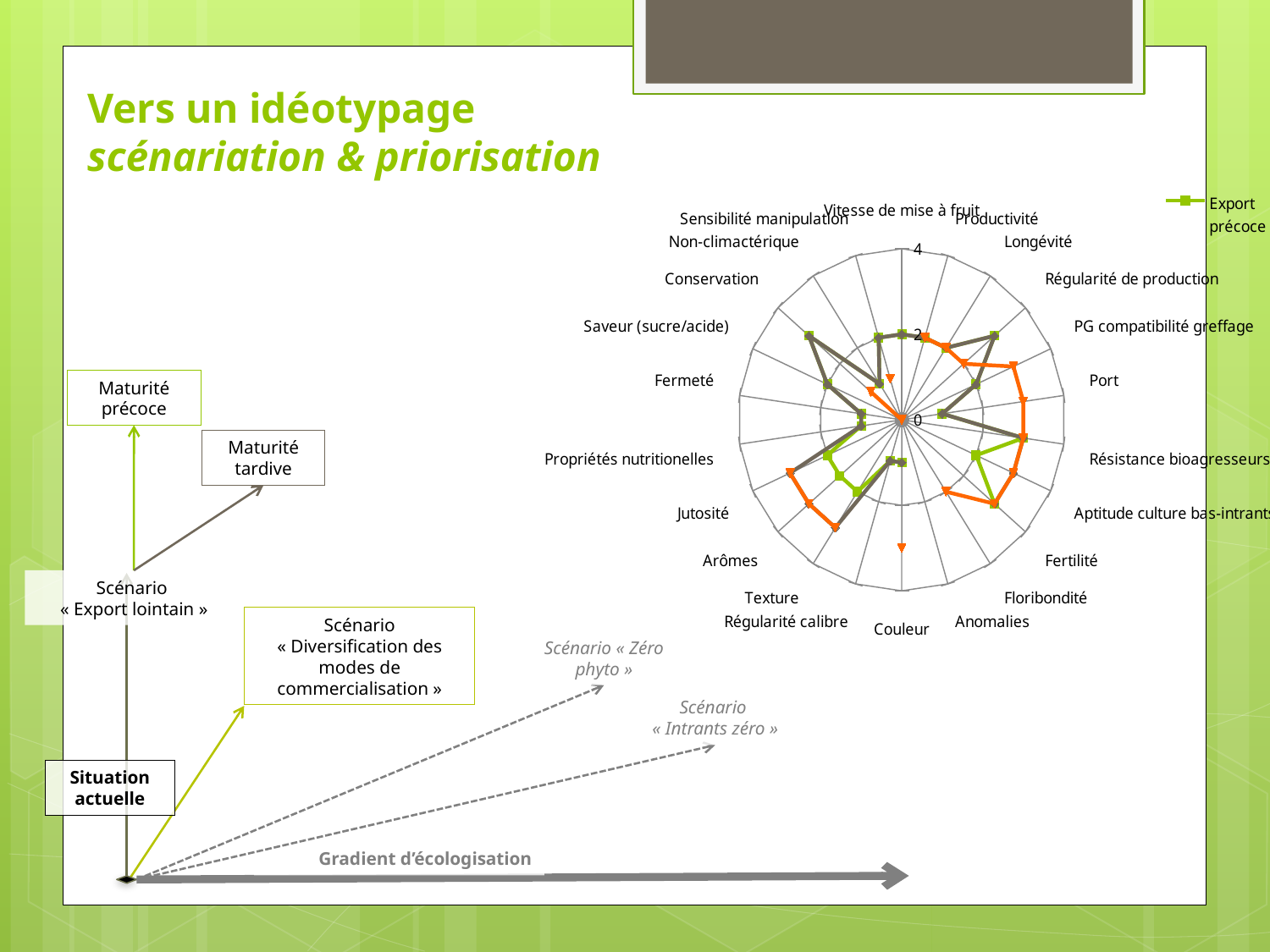
What is the maximum value shown on the radar chart's axis scale? 4 Is the value of the orange series for Port greater or less than 2? greater Is the value of the Export précoce series for Fertilité greater or less than 2? greater How many categories (axes) does the radar chart have? 22 Is the value of the Export précoce series for Vitesse de mise à fruit greater or less than 4? less What kind of chart is shown on the slide? radar chart Which series name is readable in the radar chart's legend? Export précoce